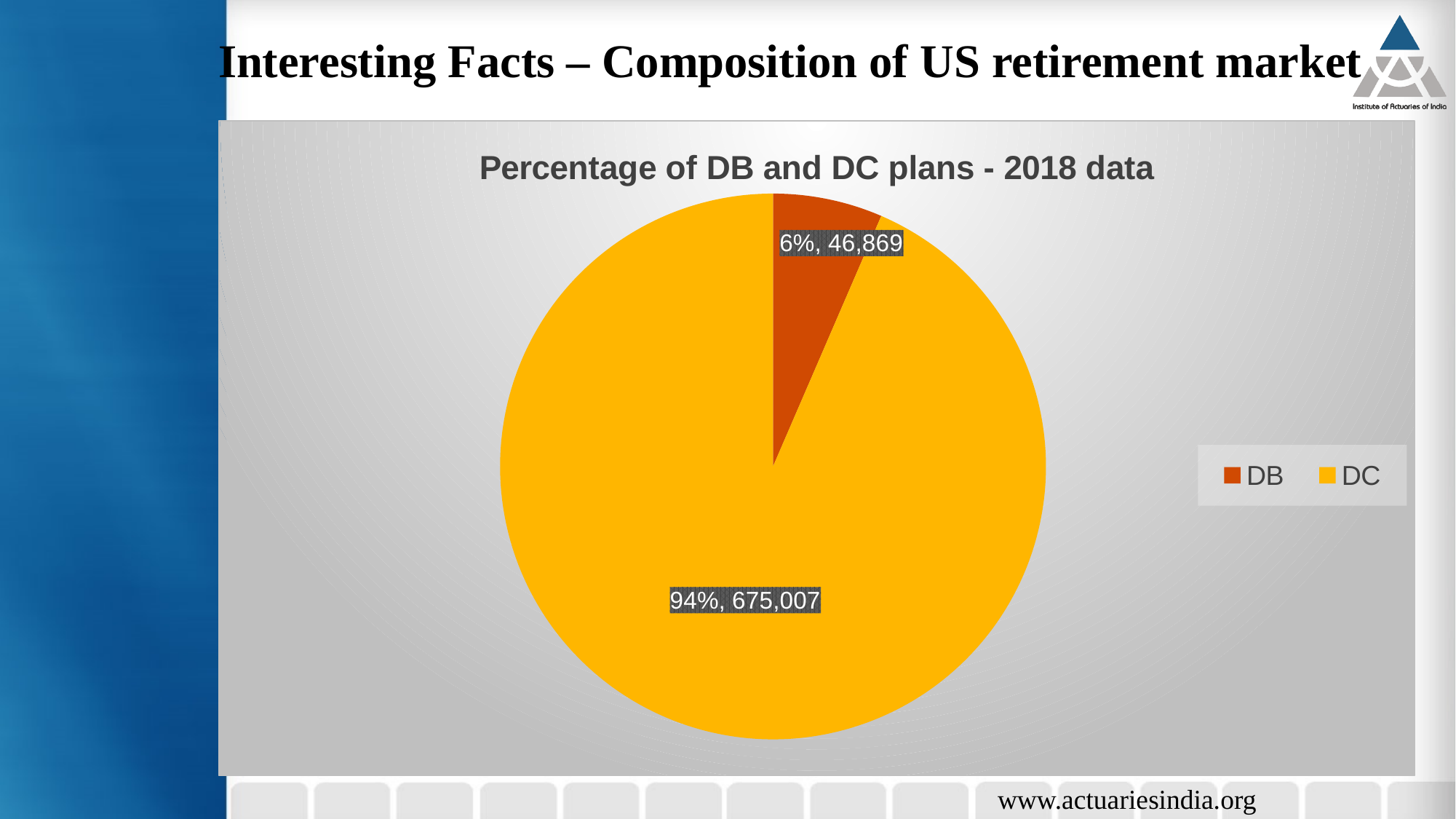
What kind of chart is shown on the slide? pie chart What is the difference between the DC value and the DB value? 628,138 How many slices does the pie chart have? 2 What is the title of the chart? Percentage of DB and DC plans - 2018 data What value is shown for DC? 675,007 Which colour represents DB in the chart? orange-red How many entries does the legend list? 2 What value is shown for DB? 46,869 Which category has the smallest slice? DB What share of the pie does DB represent? 6% What share of the pie does DC represent? 94% Which category has the largest slice? DC